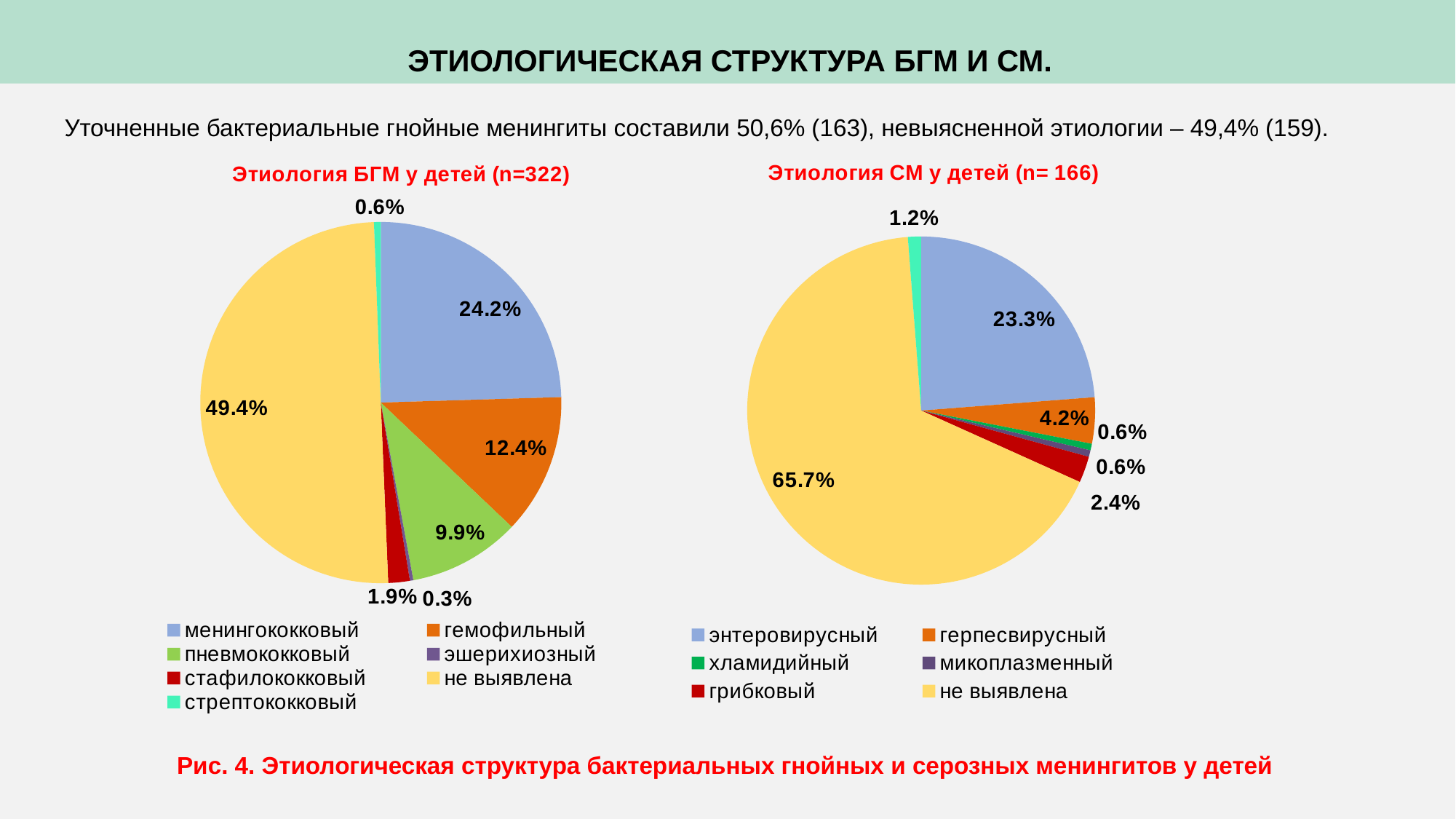
In the chart titled "Этиология БГМ у детей (n=322)", which category has the largest slice? не выявлена In the chart titled "Этиология СМ у детей (n= 166)", what share is labelled for грибковый? 2.4% In the chart titled "Этиология СМ у детей (n= 166)", what share is labelled for энтеровирусный? 23.3% What type of chart is the chart titled "Этиология СМ у детей (n= 166)"? pie chart In the chart titled "Этиология СМ у детей (n= 166)", what share is labelled for не выявлена? 65.7% In the chart titled "Этиология БГМ у детей (n=322)", what share is labelled for менингококковый? 24.2% In the chart titled "Этиология БГМ у детей (n=322)", which is larger: стафилококковый or стрептококковый? стафилококковый In the chart titled "Этиология СМ у детей (n= 166)", which is larger: герпесвирусный or грибковый? герпесвирусный How many entries does the legend of the chart titled "Этиология БГМ у детей (n=322)" list? 7 In the chart titled "Этиология БГМ у детей (n=322)", what is the difference between the shares for гемофильный and пневмококковый? 2.5% In the chart titled "Этиология БГМ у детей (n=322)", which category has the smallest slice? эшерихиозный In the chart titled "Этиология БГМ у детей (n=322)", what share is labelled for пневмококковый? 9.9%